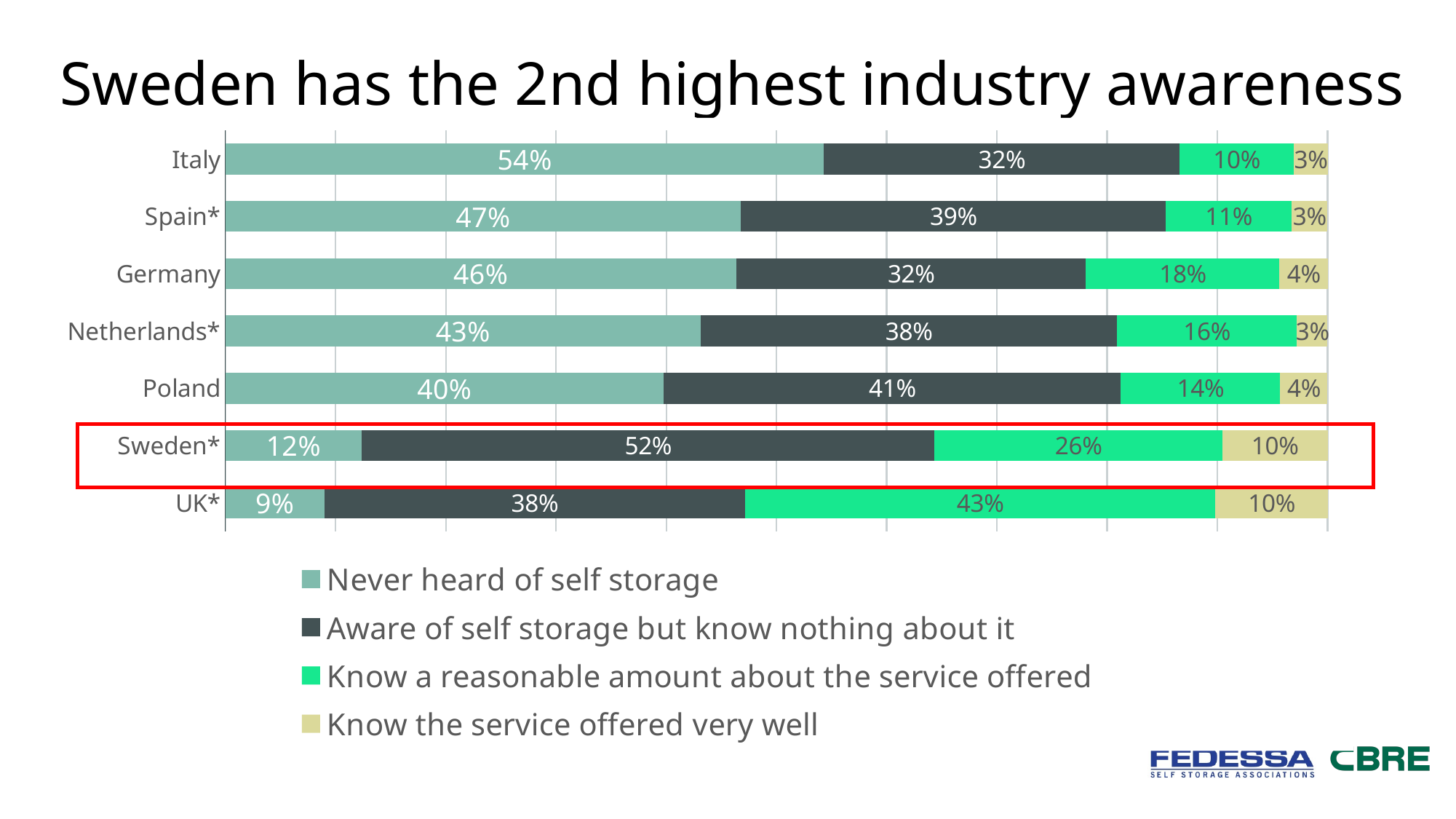
What percentage of respondents in Sweden* know a reasonable amount about the service offered? 26% What percentage of respondents in the UK* know the service offered very well? 10% What kind of chart is shown on the slide? Stacked bar chart How many countries are shown in the chart? 7 What is the difference between the 'Never heard of self storage' share for Italy and for Sweden*? 42 percentage points Which country's bar is highlighted with a red box? Sweden* Which country has the highest share of respondents who know a reasonable amount about the service offered? UK* Which is larger: the 'Aware of self storage but know nothing about it' share for Poland or for Germany? Poland Which country has the lowest share of respondents who have never heard of self storage? UK* How many series does the legend list? 4 Which country has the highest share of respondents who have never heard of self storage? Italy What percentage of respondents in Italy have never heard of self storage? 54%